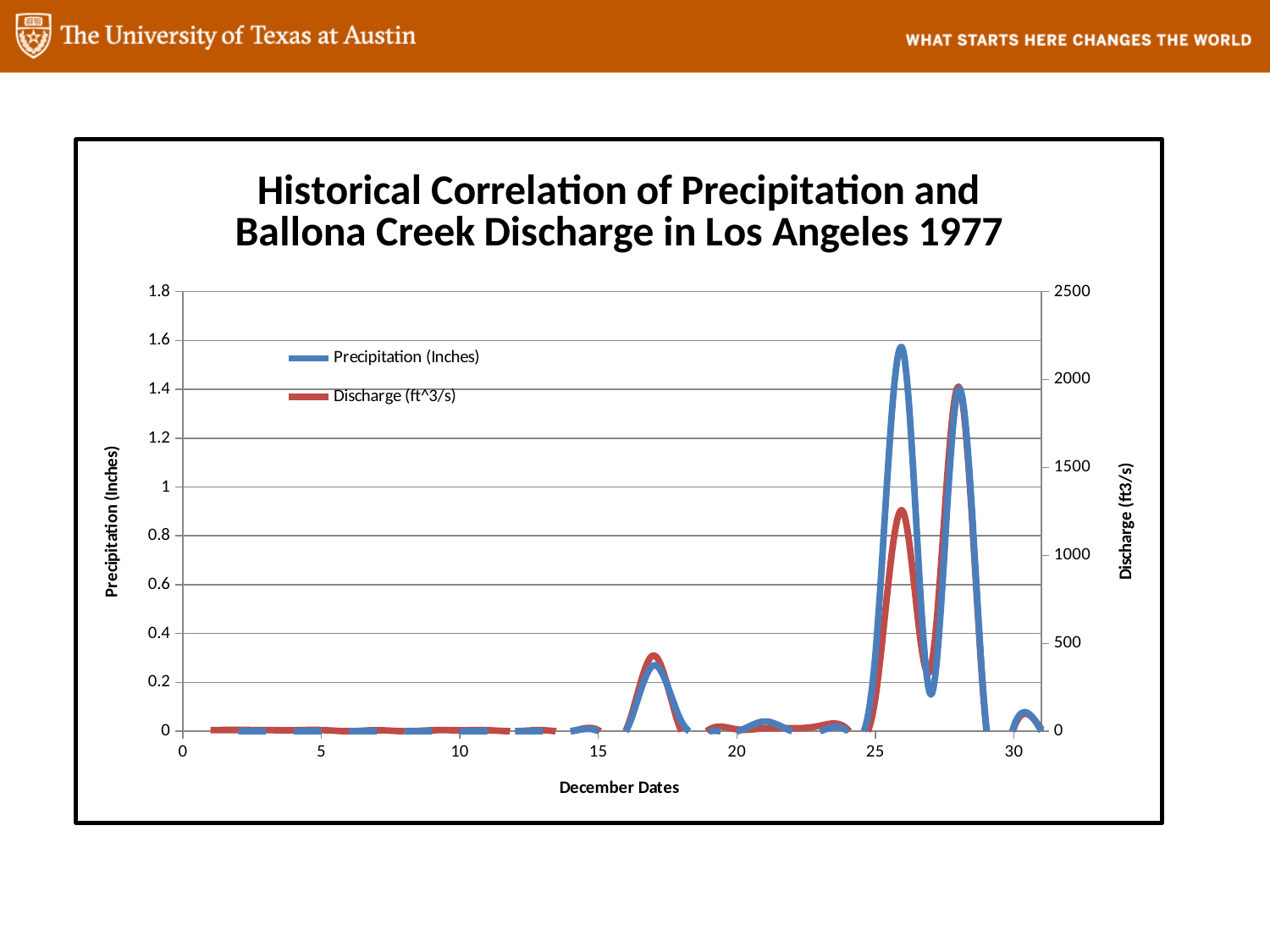
What colour is the Precipitation (Inches) line? Blue Is the value of Precipitation (Inches) around December 30 greater or less than 0.2? less Is the peak value of Precipitation (Inches) around December 26 greater or less than 1.4? greater What is the title of the chart? Historical Correlation of Precipitation and Ballona Creek Discharge in Los Angeles 1977 Does the Precipitation (Inches) line rise or fall between December 26 and December 27? Falls Is the value of Precipitation (Inches) around December 17 greater or less than 0.4? less Does the Discharge (ft^3/s) line rise or fall between December 27 and December 28? Rises What kind of chart is shown on the slide? Line chart How many series does the legend list? 2